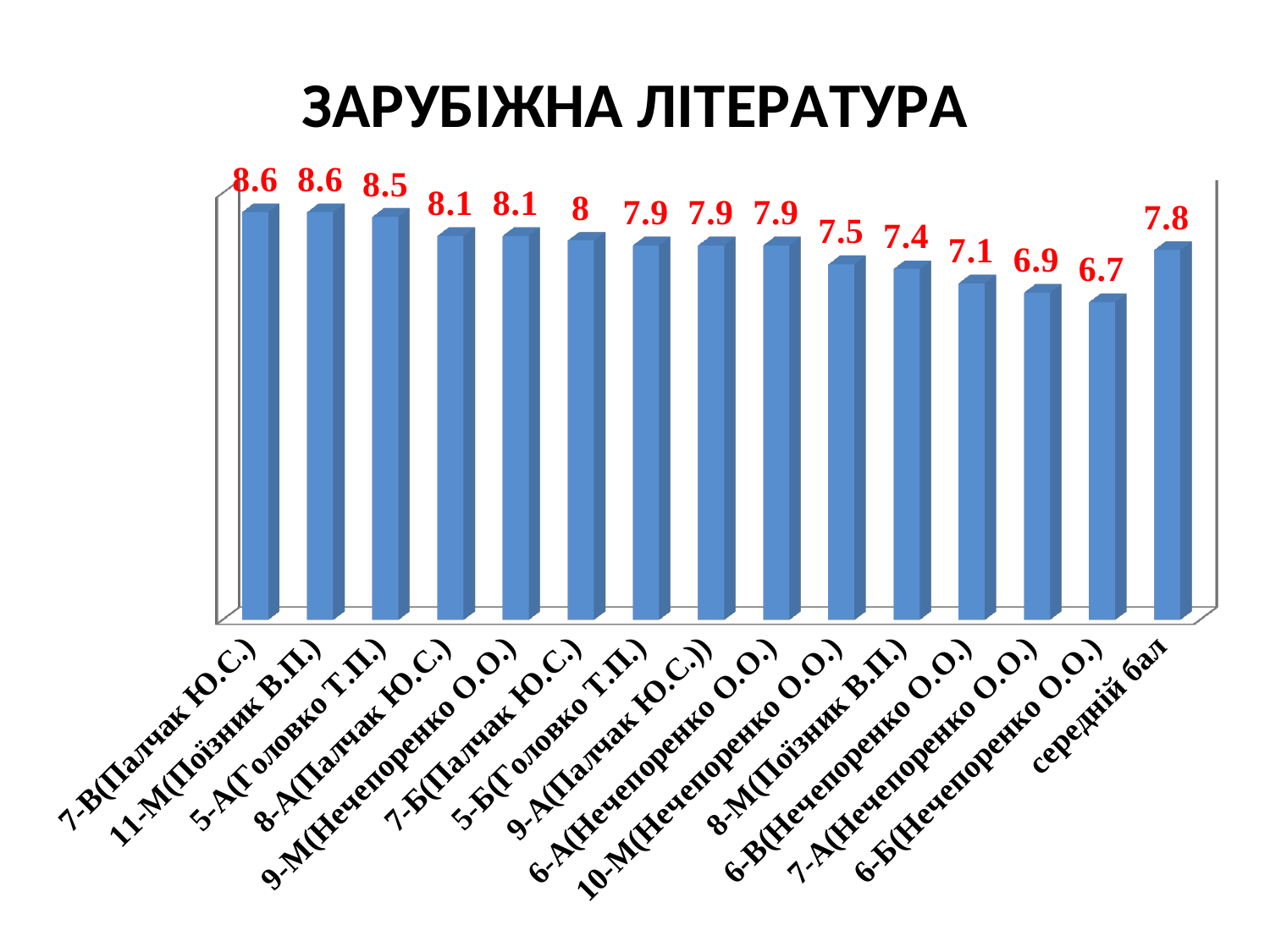
Which is larger, the value for 8-А(Палчак Ю.С.) or the value for 6-В(Нечепоренко О.О.)? 8-А(Палчак Ю.С.) Which category has the lowest value? 6-Б(Нечепоренко О.О.) What is the title of the chart? ЗАРУБІЖНА ЛІТЕРАТУРА What is the value for 10-М(Нечепоренко О.О.)? 7.5 What is the value for 7-Б(Палчак Ю.С.)? 8 What is the difference between the values for 7-В(Палчак Ю.С.) and 6-Б(Нечепоренко О.О.)? 1.9 What kind of chart is shown on the slide? bar chart How many bars are shown in the chart? 15 What is the difference between the values for 8-М(Поізник В.П.) and 7-А(Нечепоренко О.О.)? 0.5 Which is larger, the value for 6-Б(Нечепоренко О.О.) or the value for середній бал? середній бал What is the value shown for середній бал? 7.8 What is the value for 5-А(Головко Т.П.)? 8.5